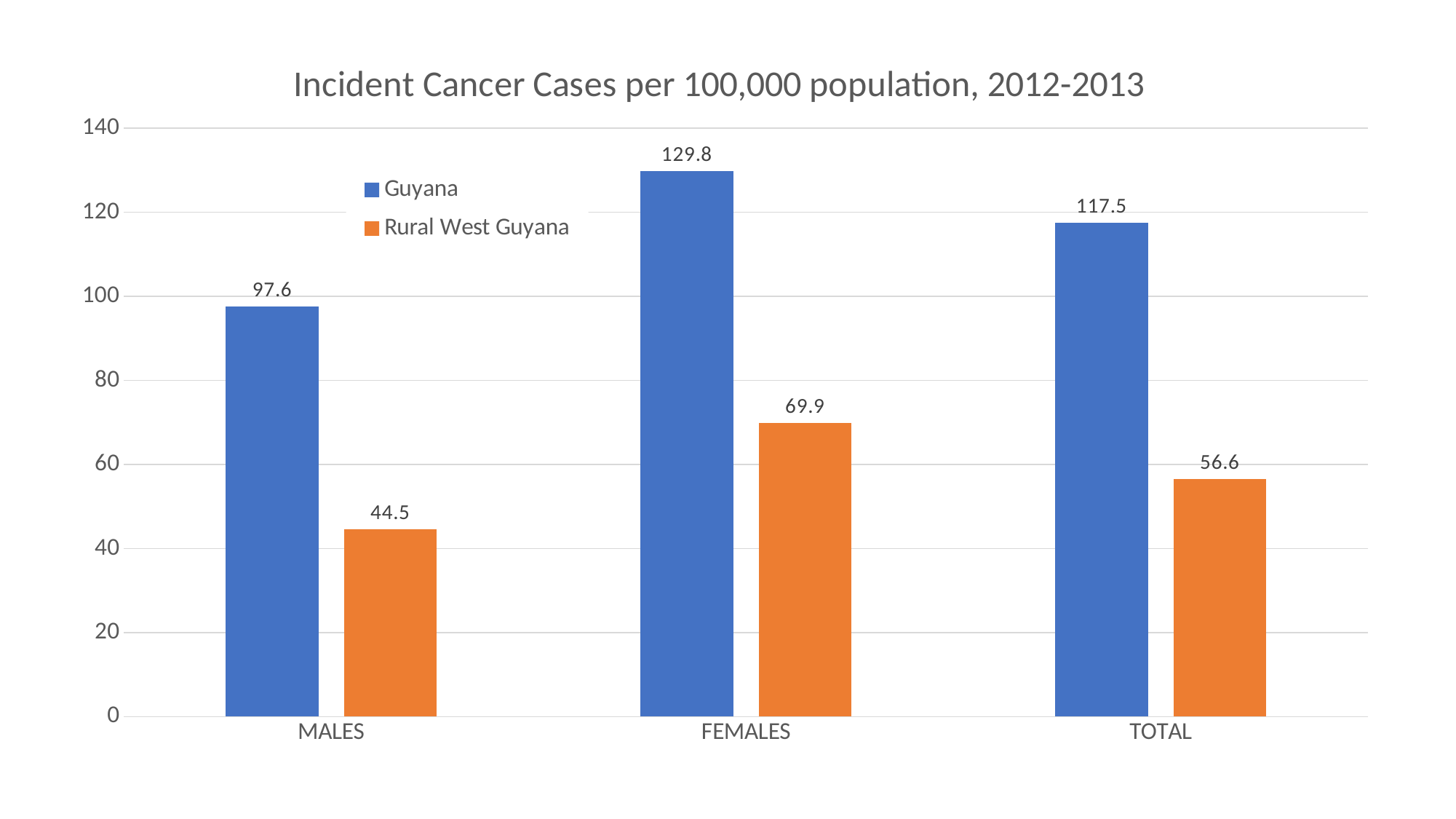
Which category has the highest value for Guyana? FEMALES Is the value for Guyana in the MALES category greater or less than 100? less What is the value for Rural West Guyana in the TOTAL category? 56.6 How many series does the legend list? 2 Which category has the lowest value for Rural West Guyana? MALES What is the value for Guyana in the FEMALES category? 129.8 What is the difference between the Guyana and Rural West Guyana values for FEMALES? 59.9 What kind of chart is shown on the slide? bar chart What is the difference between the Guyana values for TOTAL and MALES? 19.9 How many categories are shown on the x axis? 3 What is the value for Rural West Guyana in the MALES category? 44.5 Which is larger, the Rural West Guyana value for FEMALES or for TOTAL? FEMALES